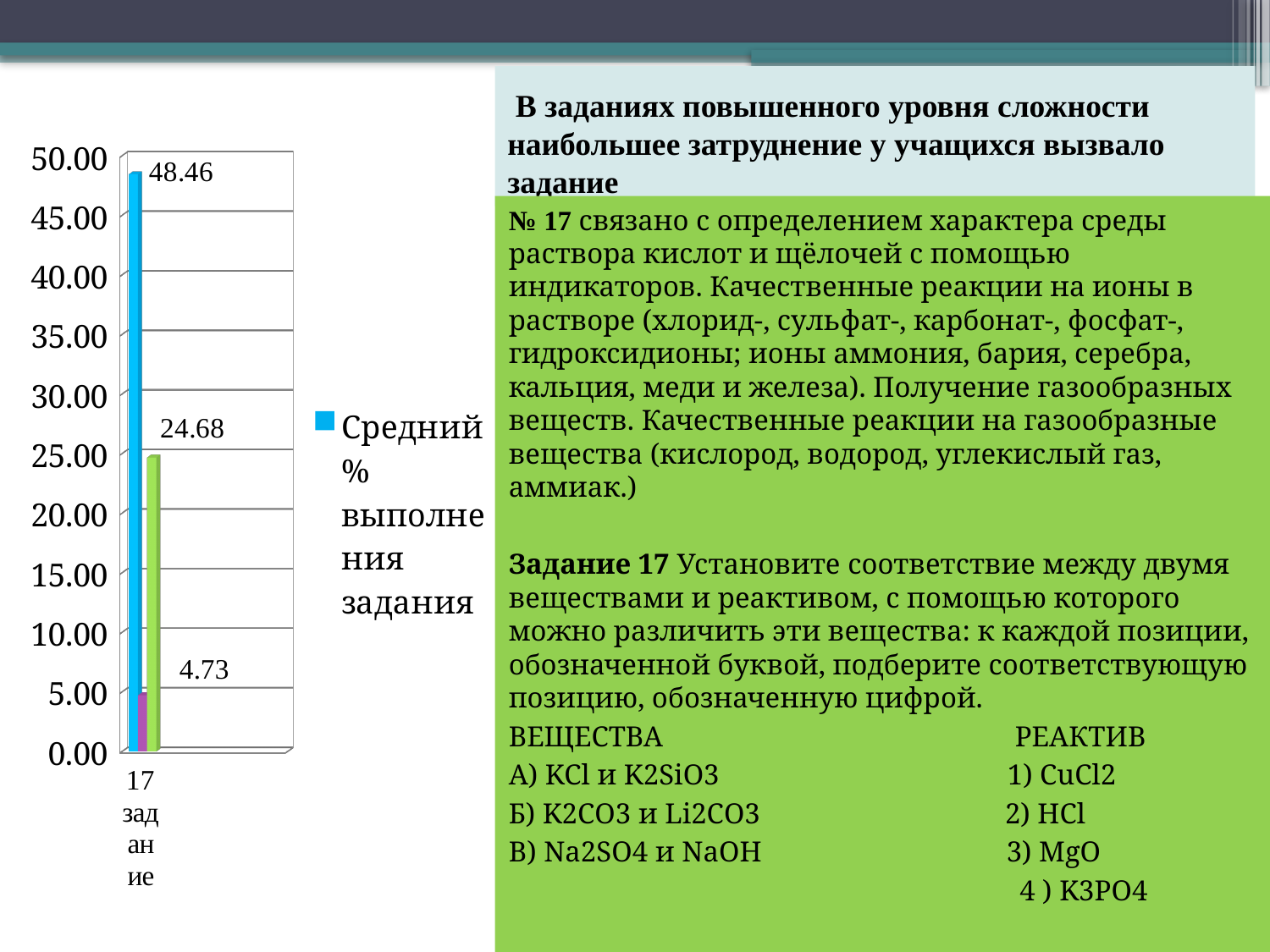
What value is labelled on the purple bar for 17 задание? 4.73 What value is labelled on the green bar for 17 задание? 24.68 Which bar has the lowest value on the chart? The purple bar, 4.73 Which is larger, the blue bar or the green bar? The blue bar Which bar has the highest value on the chart? The blue bar (Средний % выполнения задания), 48.46 What is the value of the blue bar (Средний % выполнения задания) for 17 задание? 48.46 What kind of chart is shown on the slide? Bar chart Is the value of the blue bar greater or less than 45.00? greater How many series does the chart legend list? 1 How many categories are shown on the x axis of the chart? 1 What is the difference between the green bar (24.68) and the purple bar (4.73)? 19.95 What is the difference between the blue bar (48.46) and the green bar (24.68)? 23.78